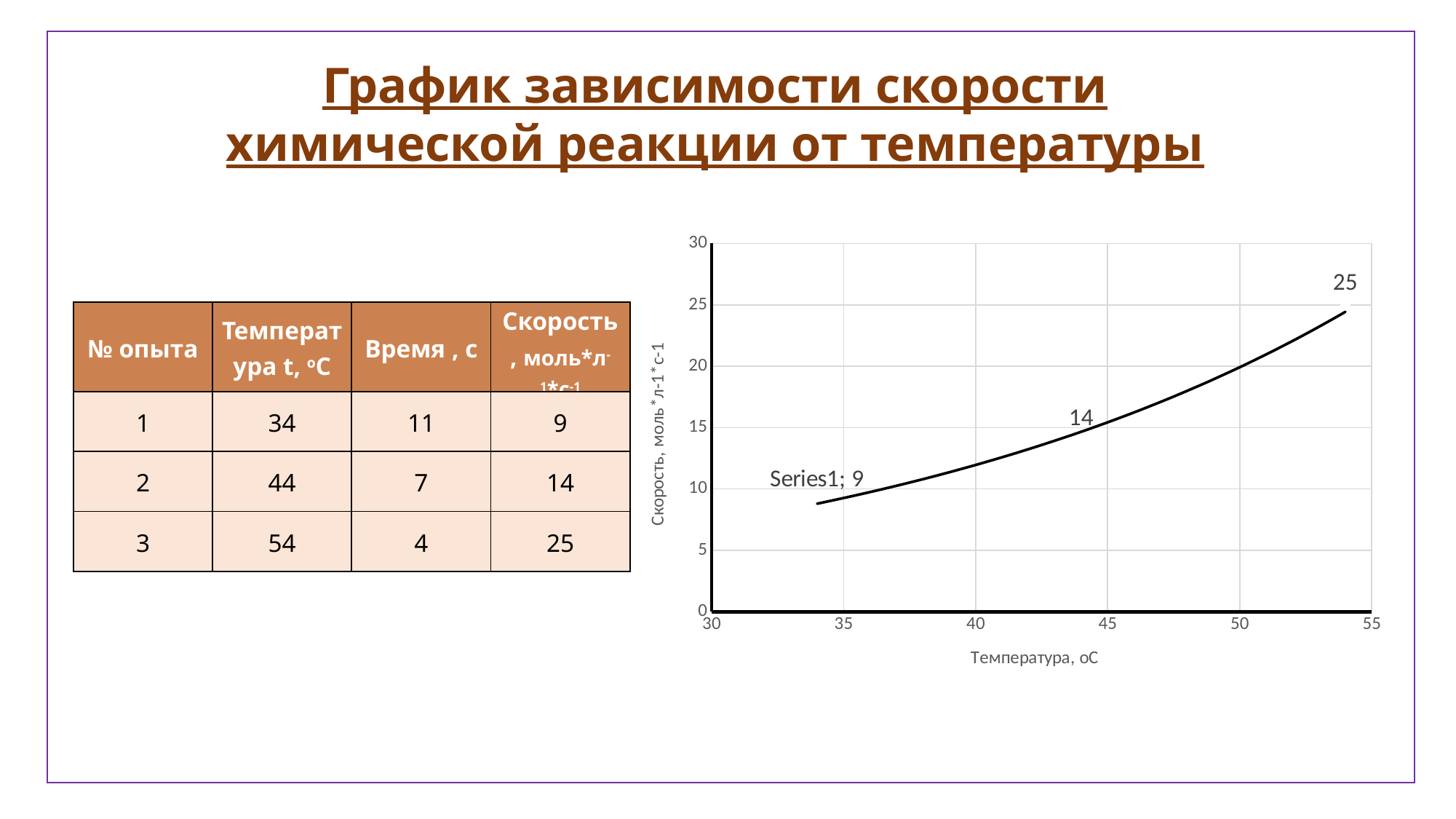
What is the reaction rate (скорость) at a temperature of 54 °C? 25 What is the difference between the reaction rate at 44 °C and at 34 °C? 5 What is the reaction rate (скорость) at a temperature of 44 °C? 14 What kind of chart is shown on the slide? line chart What is the difference between the reaction rate at 54 °C and at 44 °C? 11 What is the label of the x axis of the chart? Температура, оС How many data points are plotted on the chart? 3 Does the reaction rate rise or fall as temperature increases along the x axis? rises What is the reaction rate (скорость) at a temperature of 34 °C? 9 At which temperature is the reaction rate highest? 54 °C Which is larger: the reaction rate at 44 °C or at 34 °C? 44 °C At which temperature is the reaction rate lowest? 34 °C